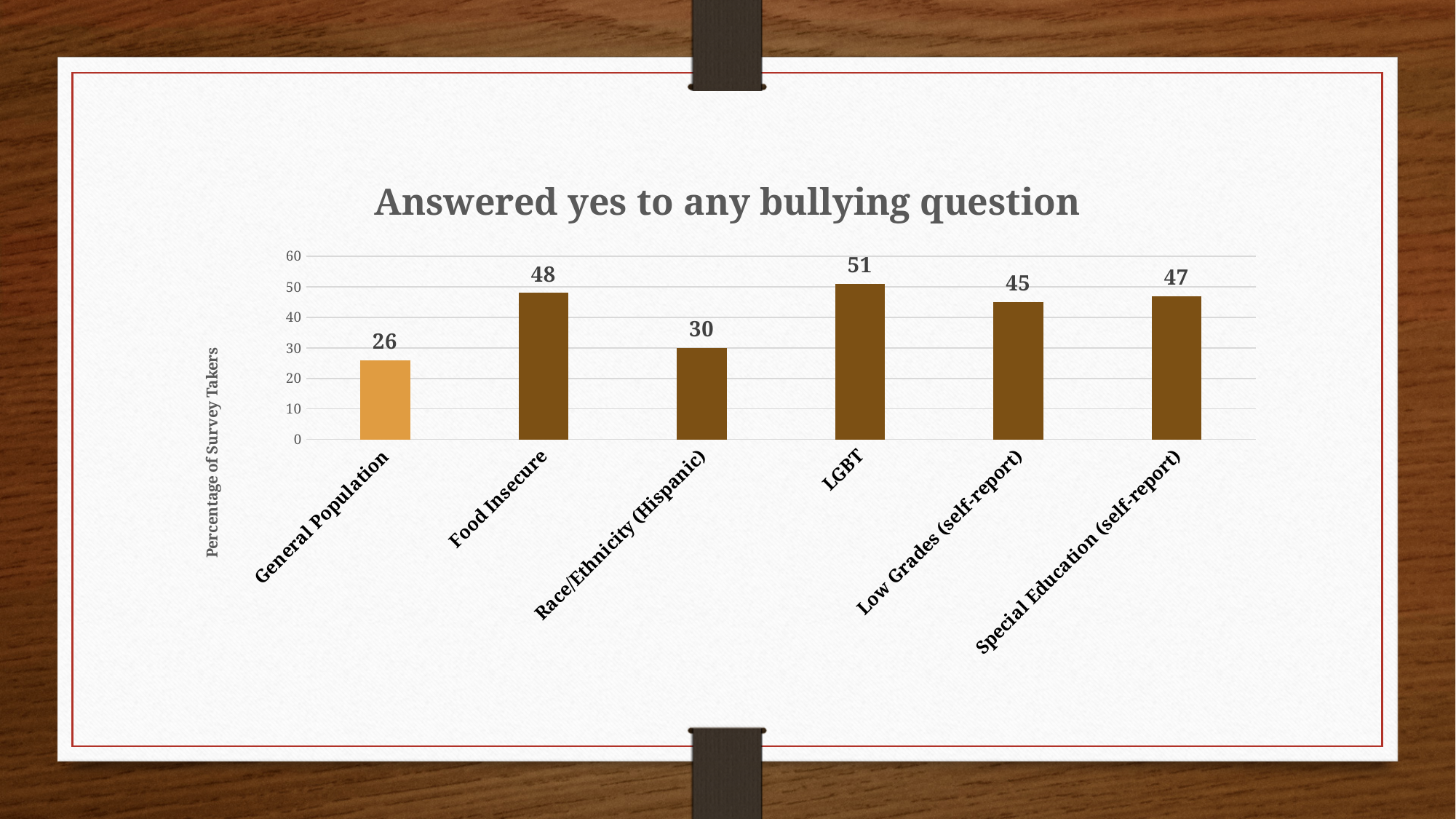
Is the value for Food Insecure greater or less than 40? greater Which is larger, the value for Special Education (self-report) or the value for Low Grades (self-report)? Special Education (self-report) Which category has the lowest value? General Population What is the value for General Population? 26 Which category has the highest value? LGBT What is the difference between the values for LGBT and General Population? 25 What is the value for Low Grades (self-report)? 45 What is the value for LGBT? 51 How many categories are shown in the chart? 6 What is the difference between the values for Food Insecure and Race/Ethnicity (Hispanic)? 18 What kind of chart is shown on the slide? bar chart What is the title of the chart? Answered yes to any bullying question